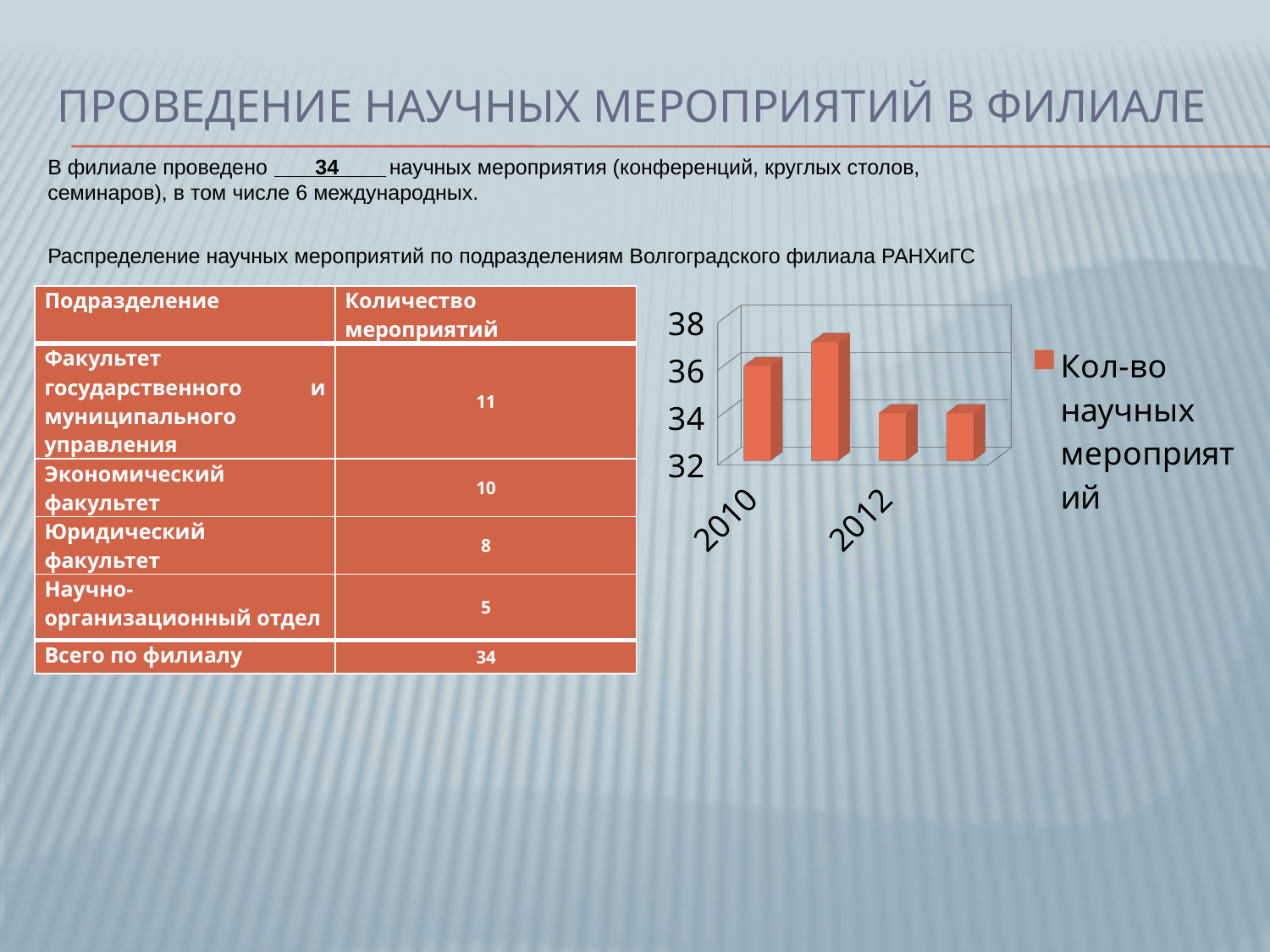
How many bars are plotted in the chart? 4 What is the highest tick value shown on the vertical axis of the chart? 38 Is the value for 2012 greater or less than 32? greater Which is larger, the value for 2010 or the value for 2012? 2010 What kind of chart is shown on the slide? bar chart How many series does the chart legend list? 1 Is the value for 2012 greater or less than 36? less Is the value for 2010 greater or less than 34? greater What is the legend entry of the chart? Кол-во научных мероприятий